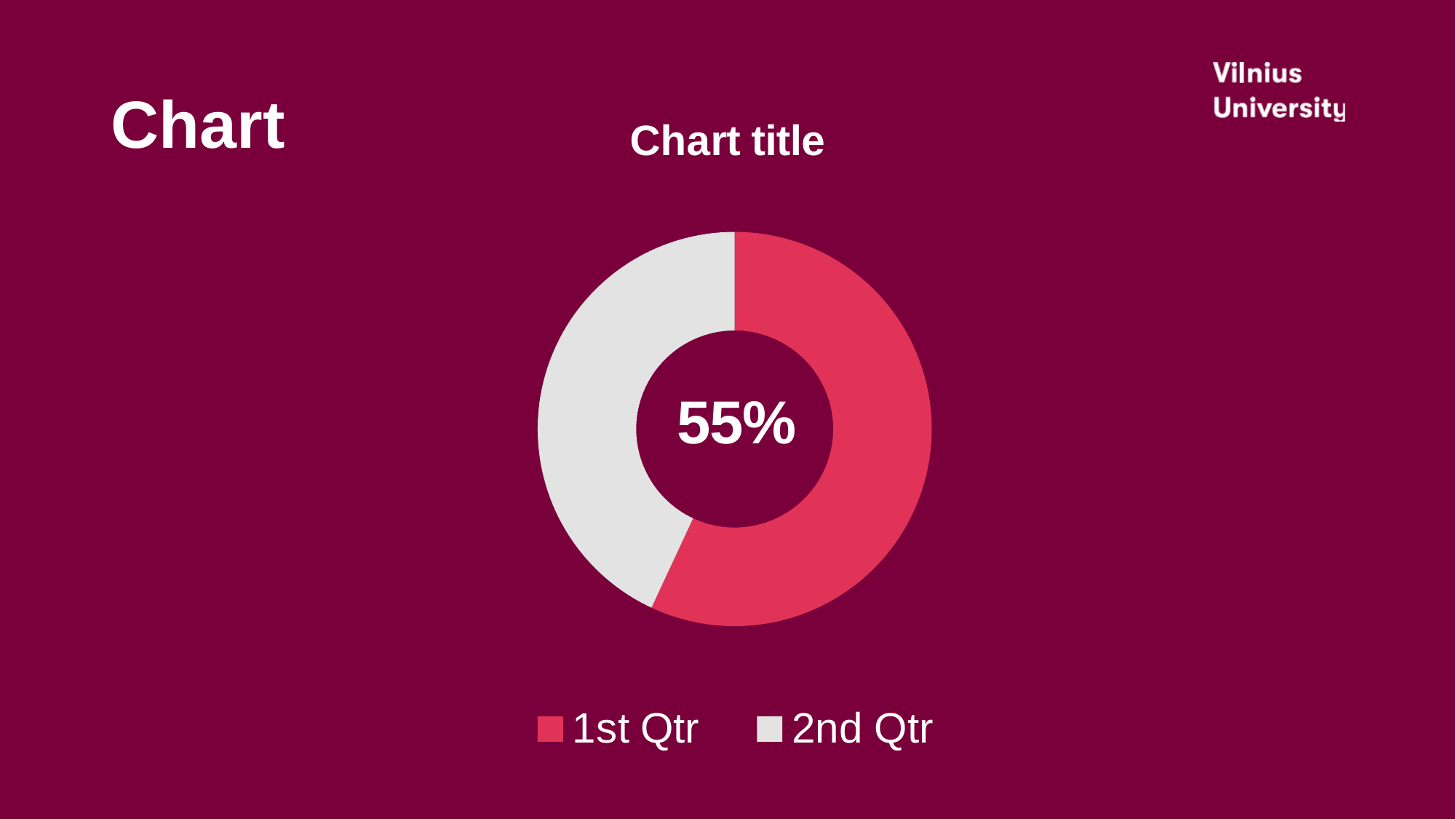
Which category has the largest share of the chart? 1st Qtr Which category has the smallest share of the chart? 2nd Qtr Which category has the larger share of the doughnut, 1st Qtr or 2nd Qtr? 1st Qtr Is the share of 1st Qtr greater or less than 50%? greater Is the share of 2nd Qtr greater or less than 50%? less Which colour represents 2nd Qtr in the chart? Light grey What is the title of the chart? Chart title What kind of chart is shown on the slide? Doughnut chart What percentage is printed in the centre of the doughnut chart? 55% How many categories does the chart's legend list? 2